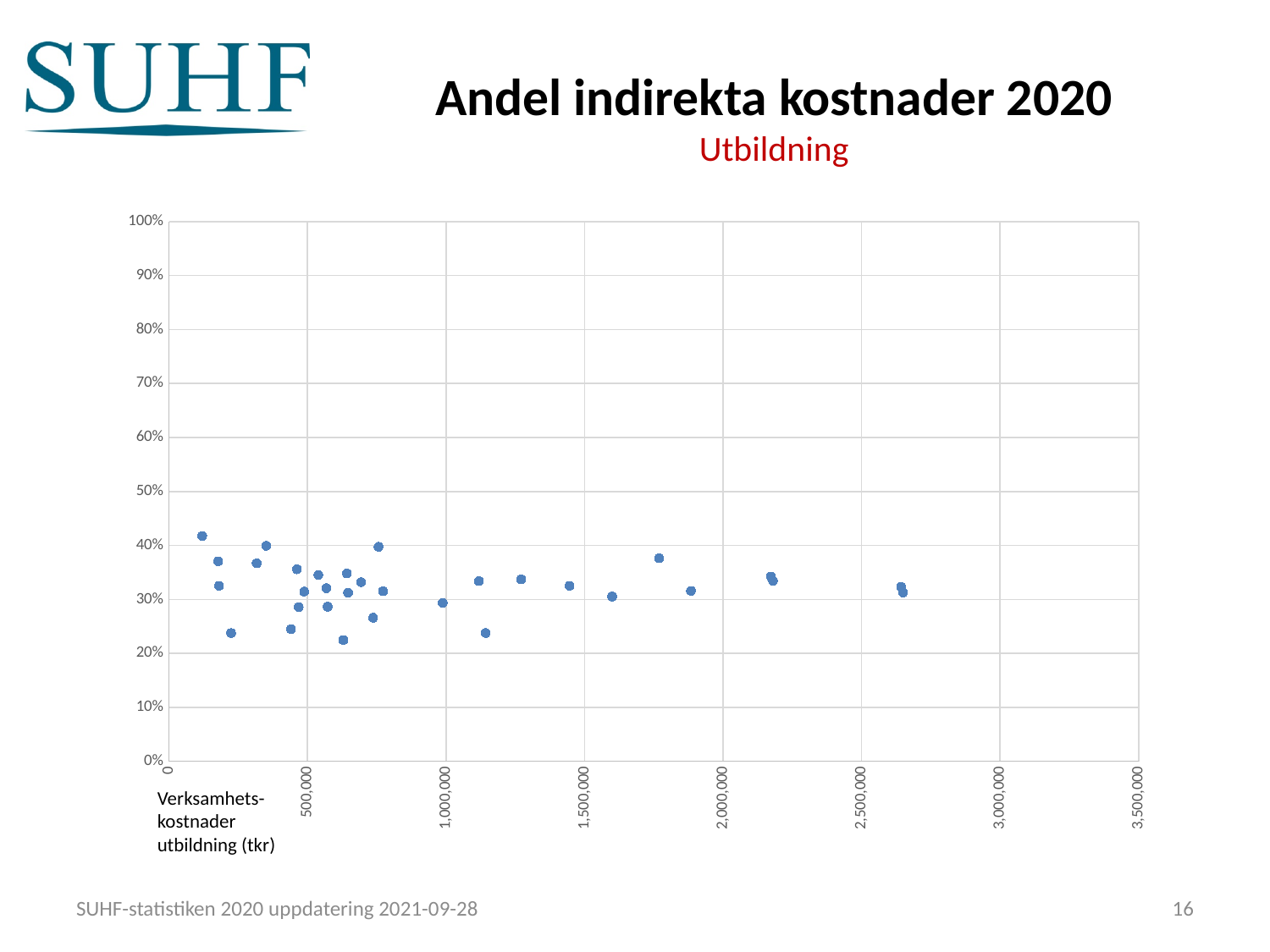
Is the largest x-axis value among the plotted points greater or less than 2,500,000? greater What is the title of the chart on the slide? Andel indirekta kostnader 2020 What kind of chart is shown on the slide? scatter chart What is the highest tick value shown on the x axis? 3,500,000 What is the highest tick value shown on the y axis? 100% Do the plotted values show a strong rising trend as the x-axis value increases? no What label is shown for the x axis of the chart? Verksamhetskostnader utbildning (tkr) Is the highest plotted value on the y axis greater or less than 40%? greater Is the highest plotted value on the y axis greater or less than 50%? less